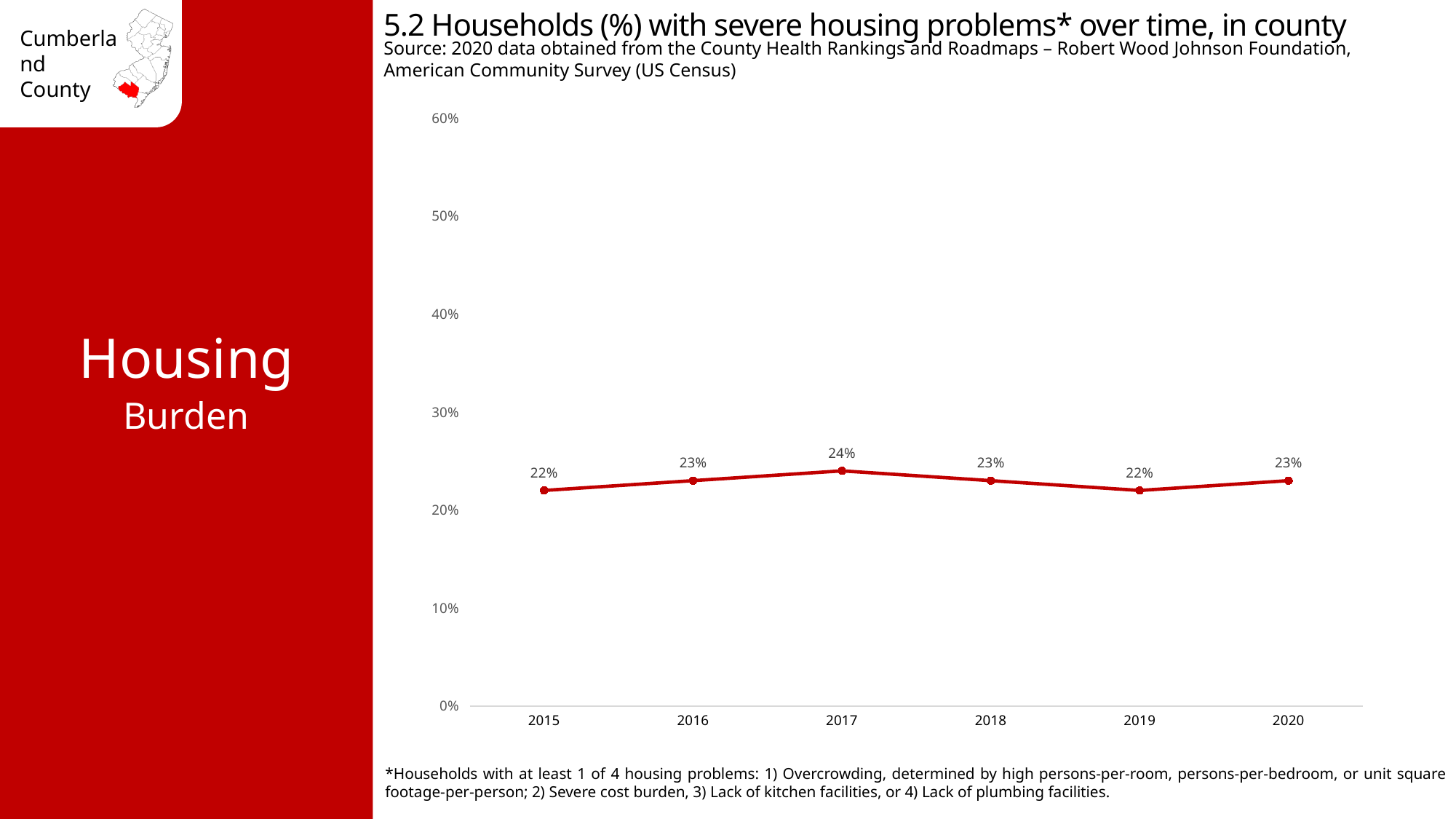
What percentage of households had severe housing problems in 2017? 24% Is the value for 2016 greater or less than 20%? greater Does the value rise or fall from 2017 to 2019? fall What kind of chart is shown on the slide? line chart Which year has the highest percentage of households with severe housing problems? 2017 What is the value shown for 2015? 22% Is the value for 2018 greater or less than 30%? less What is the value shown for 2020? 23% How many years are plotted on the chart? 6 What is the title of the chart? 5.2 Households (%) with severe housing problems* over time, in county What is the difference between the 2017 value and the 2019 value? 2% Does the value rise or fall from 2015 to 2017? rise